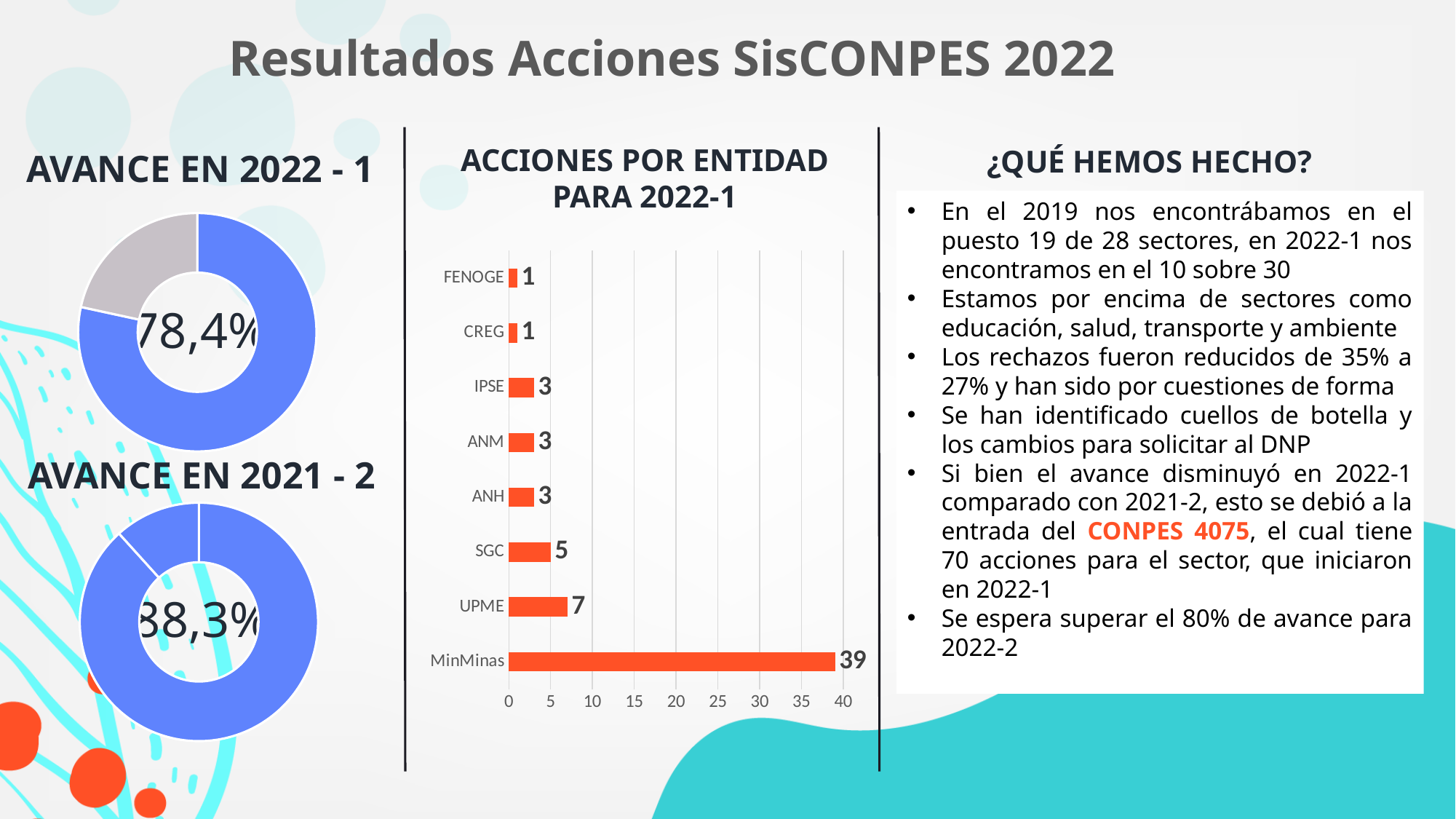
In the chart titled 'ACCIONES POR ENTIDAD PARA 2022-1', which has more actions, SGC or IPSE? SGC In the chart titled 'ACCIONES POR ENTIDAD PARA 2022-1', how many entities are shown? 8 In the chart titled 'ACCIONES POR ENTIDAD PARA 2022-1', what is the difference between the actions of MinMinas and UPME? 32 In the chart titled 'ACCIONES POR ENTIDAD PARA 2022-1', what is the highest value shown on the horizontal axis? 40 What percentage is shown in the donut chart under 'AVANCE EN 2022 - 1'? 78,4% In the chart titled 'ACCIONES POR ENTIDAD PARA 2022-1', which entity has the highest number of actions? MinMinas What kind of chart is 'ACCIONES POR ENTIDAD PARA 2022-1'? Bar chart In the chart titled 'ACCIONES POR ENTIDAD PARA 2022-1', how many actions does MinMinas have? 39 In the chart titled 'ACCIONES POR ENTIDAD PARA 2022-1', how many entities have exactly 3 actions? 3 In the chart titled 'ACCIONES POR ENTIDAD PARA 2022-1', how many actions does UPME have? 7 In the chart titled 'ACCIONES POR ENTIDAD PARA 2022-1', how many actions does SGC have? 5 What kind of chart is shown under 'AVANCE EN 2022 - 1'? Donut chart